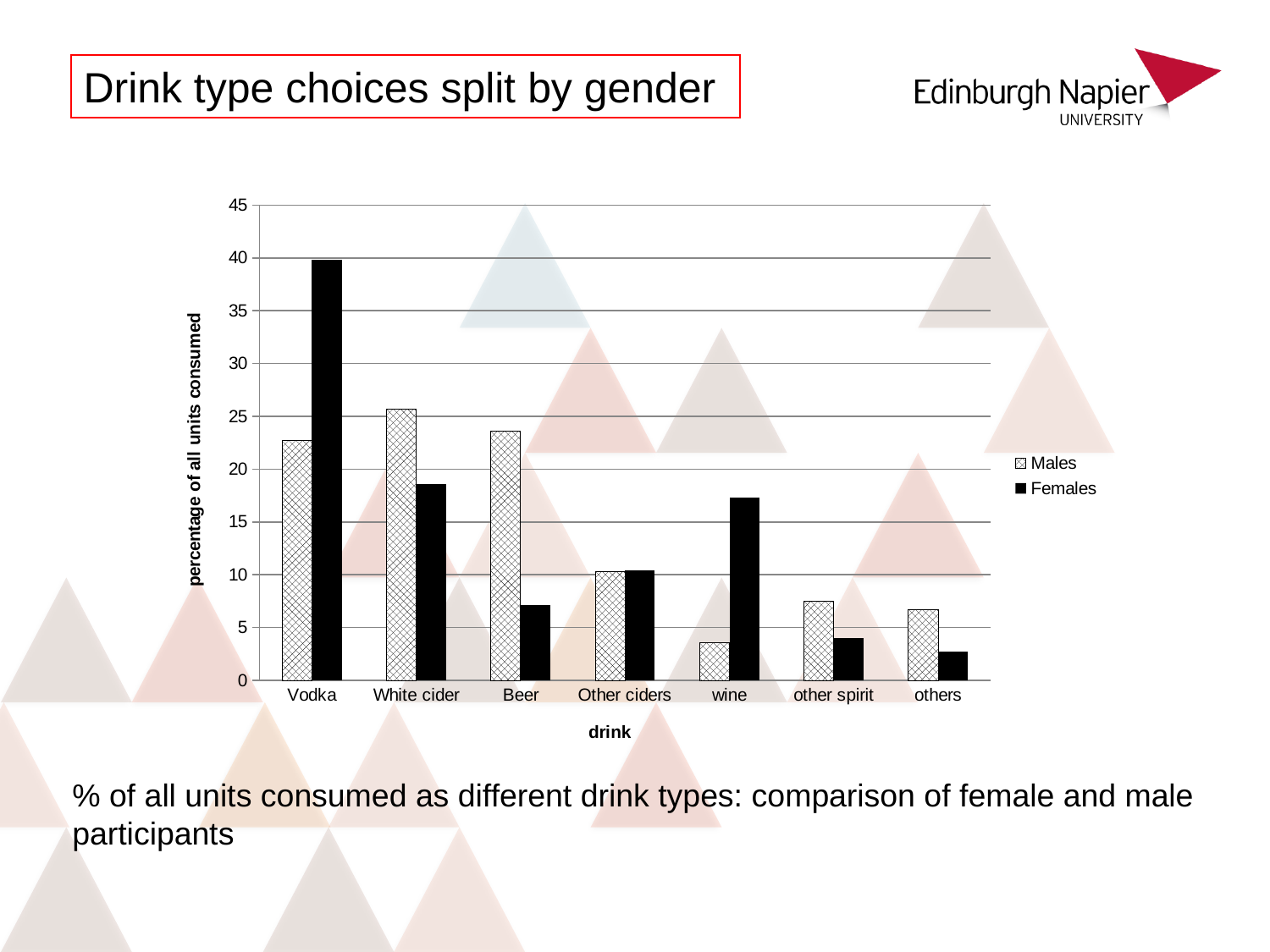
What kind of chart is shown on the slide? bar chart How many drink categories are shown on the x axis? 7 Is the Females value for Vodka greater or less than 35? greater Is the Females value for Beer greater or less than 10? less Is the Males value for wine greater or less than 5? less Which drink has the highest value for Females? Vodka For Beer, which is larger: the Males value or the Females value? Males Which drink has the lowest value for Males? wine Which drink has the lowest value for Females? others What is the label of the y axis? percentage of all units consumed For Vodka, which is larger: the Males value or the Females value? Females How many series does the legend list? 2